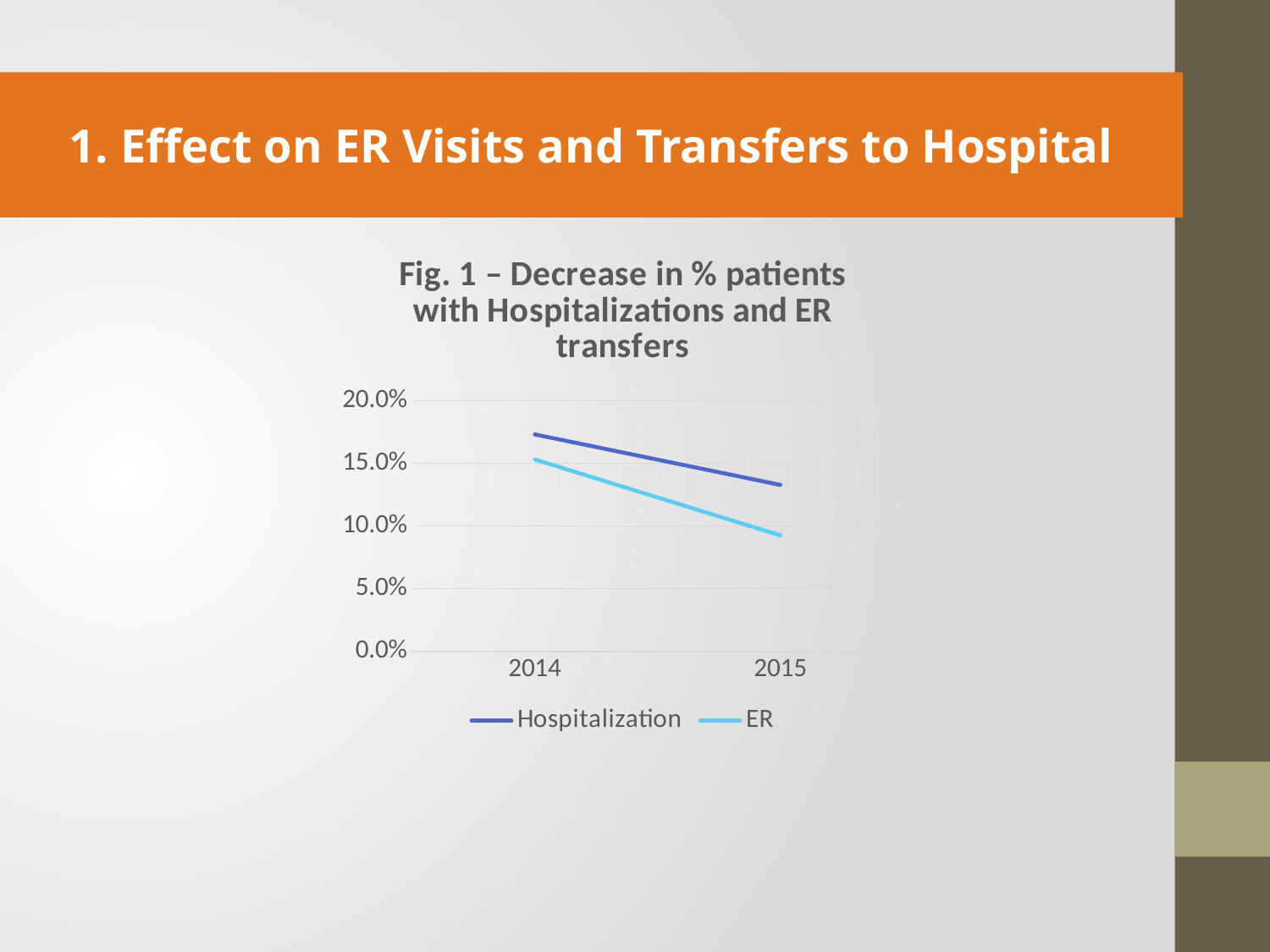
Is the Hospitalization value for 2014 greater or less than 15.0%? greater How many years are shown on the x axis? 2 What is the title of the chart? Fig. 1 – Decrease in % patients with Hospitalizations and ER transfers How many series does the legend list? 2 Is the ER value for 2014 greater or less than 10.0%? greater In 2014, which series has the higher value, Hospitalization or ER? Hospitalization Does the ER line rise or fall from 2014 to 2015? fall In 2015, which series has the higher value, Hospitalization or ER? Hospitalization Is the Hospitalization value for 2015 greater or less than 15.0%? less What kind of chart is shown on the slide? line chart Does the Hospitalization line rise or fall from 2014 to 2015? fall